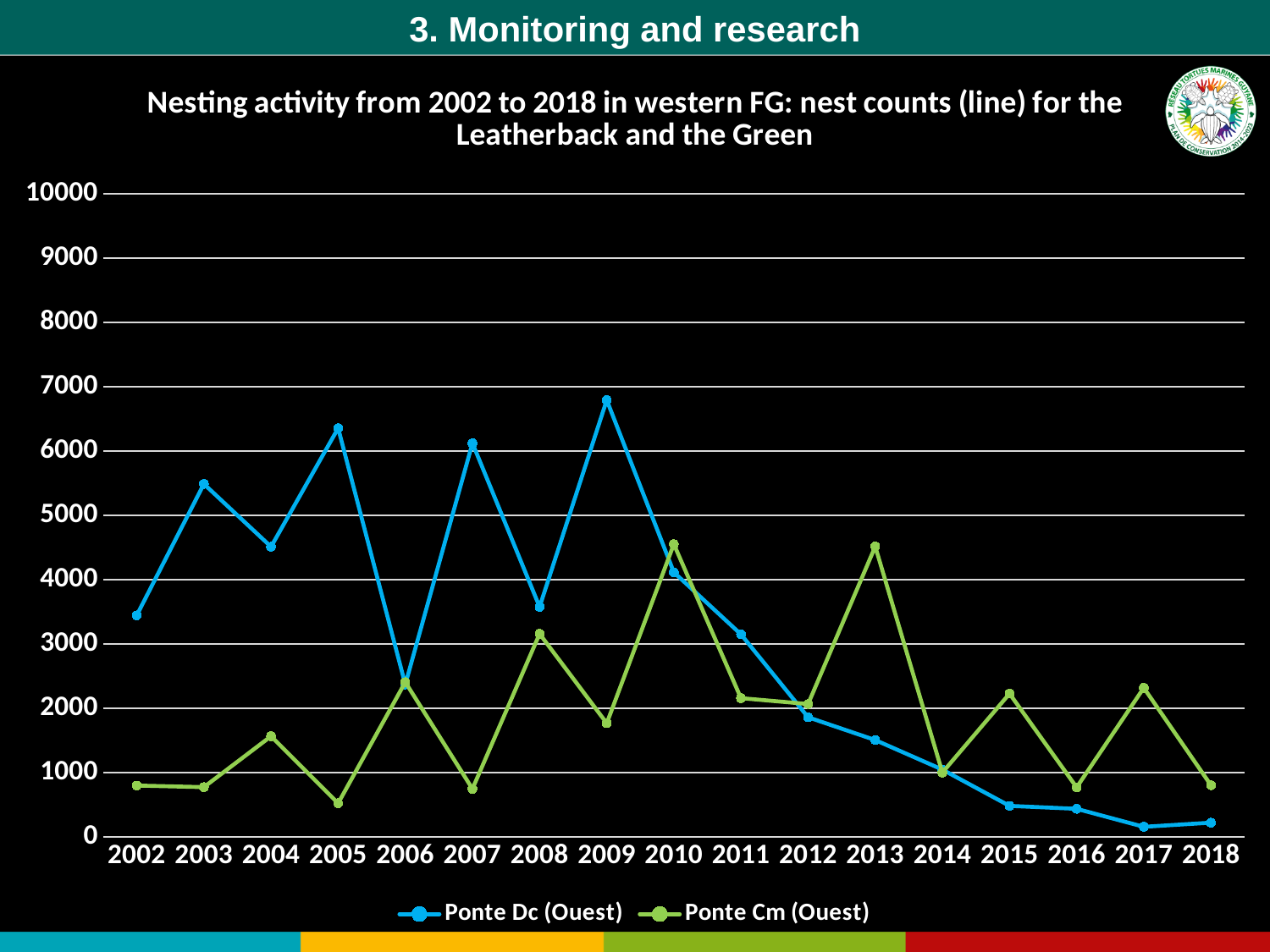
In which year does the Ponte Dc (Ouest) series reach its lowest value? 2017 In which year does the Ponte Cm (Ouest) series reach its lowest value? 2005 Does the Ponte Dc (Ouest) series rise or fall from 2011 to 2017? Fall Is the Ponte Cm (Ouest) value for 2008 greater or less than 3000? greater Is the Ponte Dc (Ouest) value for 2009 greater or less than 6000? greater How many years are plotted along the x axis? 17 Which series has the larger value in 2013, Ponte Dc (Ouest) or Ponte Cm (Ouest)? Ponte Cm (Ouest) How many series does the legend list? 2 Is the Ponte Dc (Ouest) value for 2015 greater or less than 1000? less In which year does the Ponte Dc (Ouest) series reach its highest value? 2009 Which colour is used for the Ponte Cm (Ouest) series? Green What type of chart is shown on the slide? Line chart